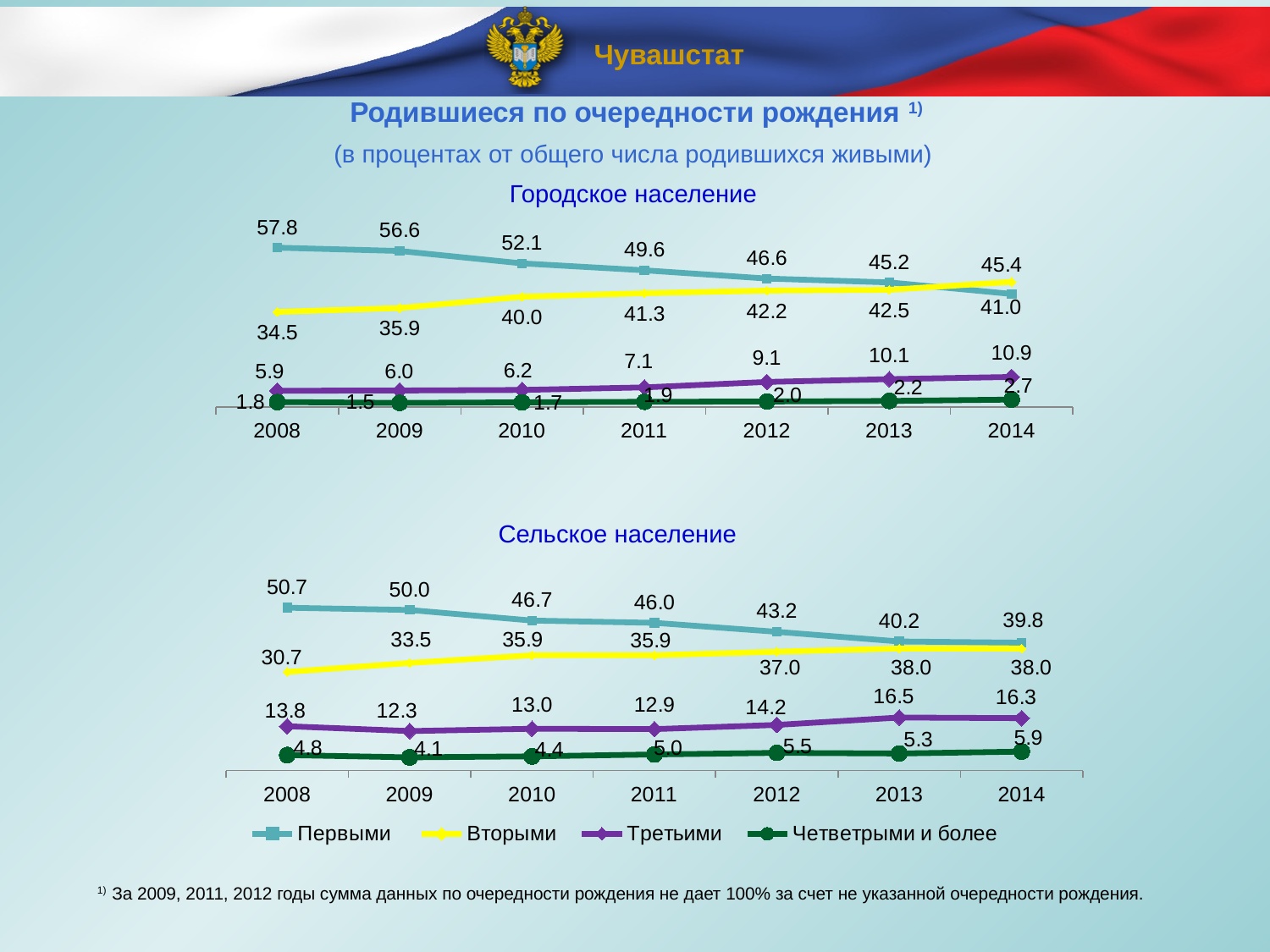
In the 'Городское население' chart, which series has the larger value in 2014, 'Первыми' or 'Вторыми'? Вторыми In the 'Городское население' chart, what is the value for 'Вторыми' in 2014? 45.4 In the 'Сельское население' chart, what is the value for 'Четвертыми и более' in 2014? 5.9 What type of chart is the 'Сельское население' chart? line chart In the 'Сельское население' chart, does the value for 'Первыми' rise or fall from 2008 to 2014? fall In the 'Городское население' chart, what is the value for 'Первыми' in 2008? 57.8 In the 'Городское население' chart, what is the value for 'Третьими' in 2012? 9.1 In the 'Сельское население' chart, in which year is the value for 'Третьими' highest? 2013 In the 'Сельское население' chart, what is the difference between the 'Первыми' values in 2008 and 2014? 10.9 In the 'Городское население' chart, in which year is the value for 'Четвертыми и более' lowest? 2009 How many series does the legend list? 4 How many years are shown on the x axis of the 'Городское население' chart? 7